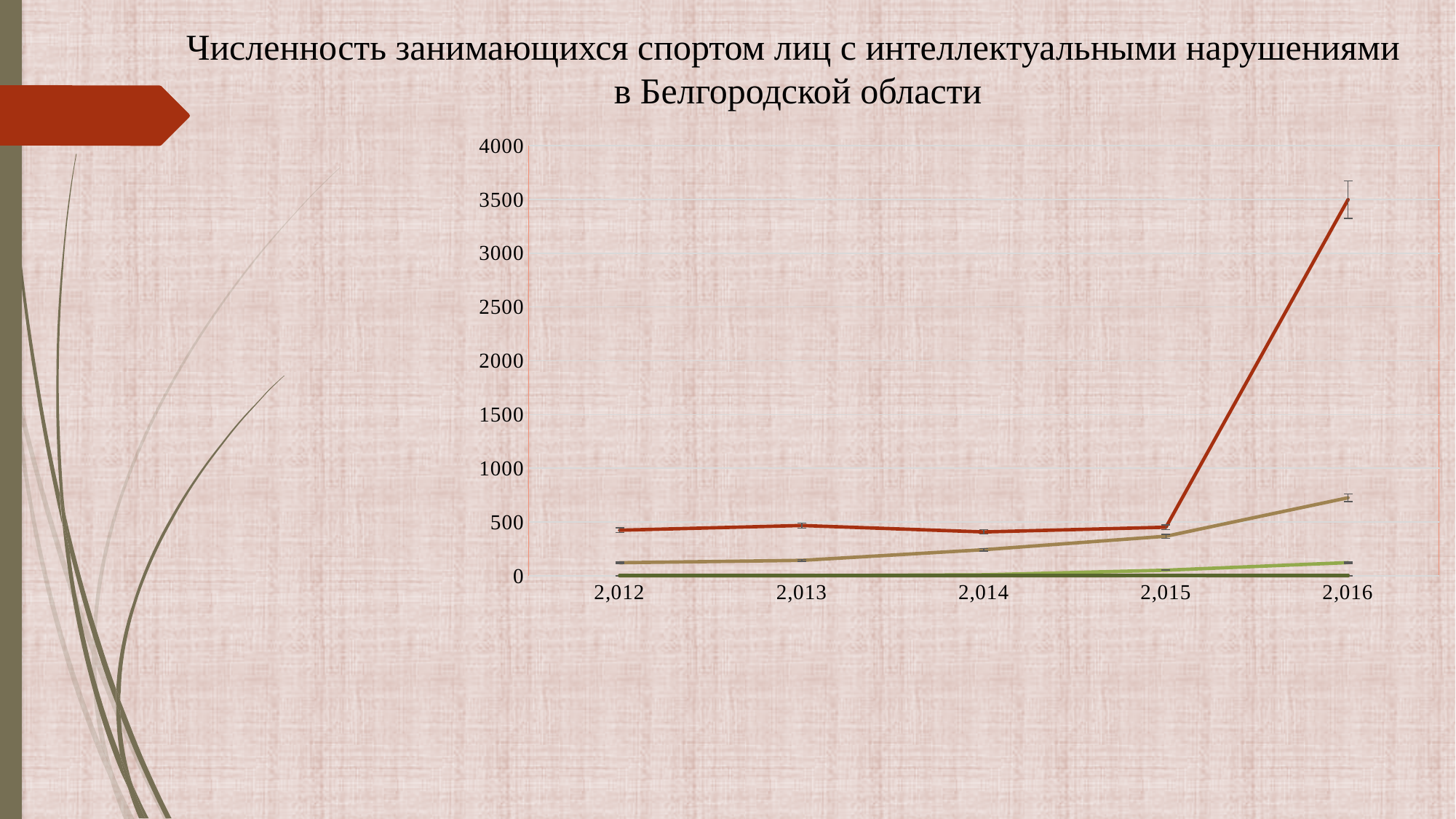
Does the tan (brown) line rise or fall from 2,012 to 2,016? rise Is the value of the tan (brown) line for 2,012 greater or less than 500? less Is the value of the tan (brown) line for 2,016 greater or less than 1000? less What kind of chart is shown on the slide? line chart In which year does the tan (brown) line have its lowest value? 2,012 Is the value of the red line for 2,012 greater or less than 1000? less What is the last year shown on the x axis? 2,016 How many years are shown along the x axis of the chart? 5 In which year does the red line reach its highest value? 2,016 What is the first year shown on the x axis? 2,012 Which line has the larger value in 2,016, the red line or the tan (brown) line? the red line